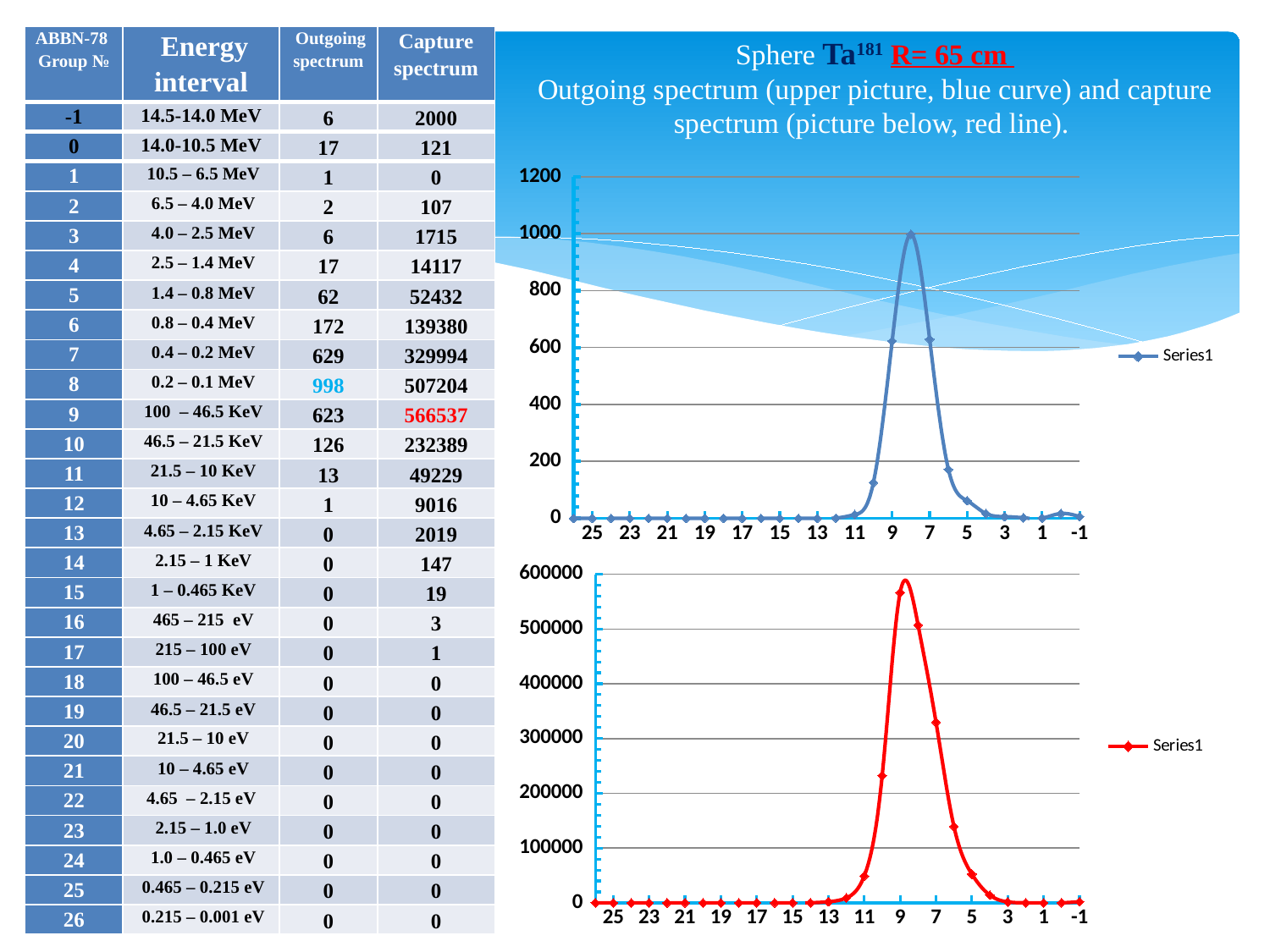
In the upper chart (blue curve), is the value at group 6 greater or less than 200? less What kind of chart is the upper chart (blue curve)? line chart In the lower chart (red curve), which is larger, the value at group 7 or the value at group 10? group 7 In the upper chart (blue curve), does the curve rise or fall as the x axis goes from group 11 to group 8? rise In the lower chart (red curve), is the value at group 9 greater or less than 500000? greater In the lower chart (red curve), is the value at group 7 greater or less than 400000? less What is the legend entry shown for the upper chart (blue curve)? Series1 In the upper chart (blue curve), at which x-axis group does the curve reach its highest value? 8 In the lower chart (red curve), at which x-axis group does the curve reach its highest value? 9 How many series does the legend of the lower chart (red curve) list? 1